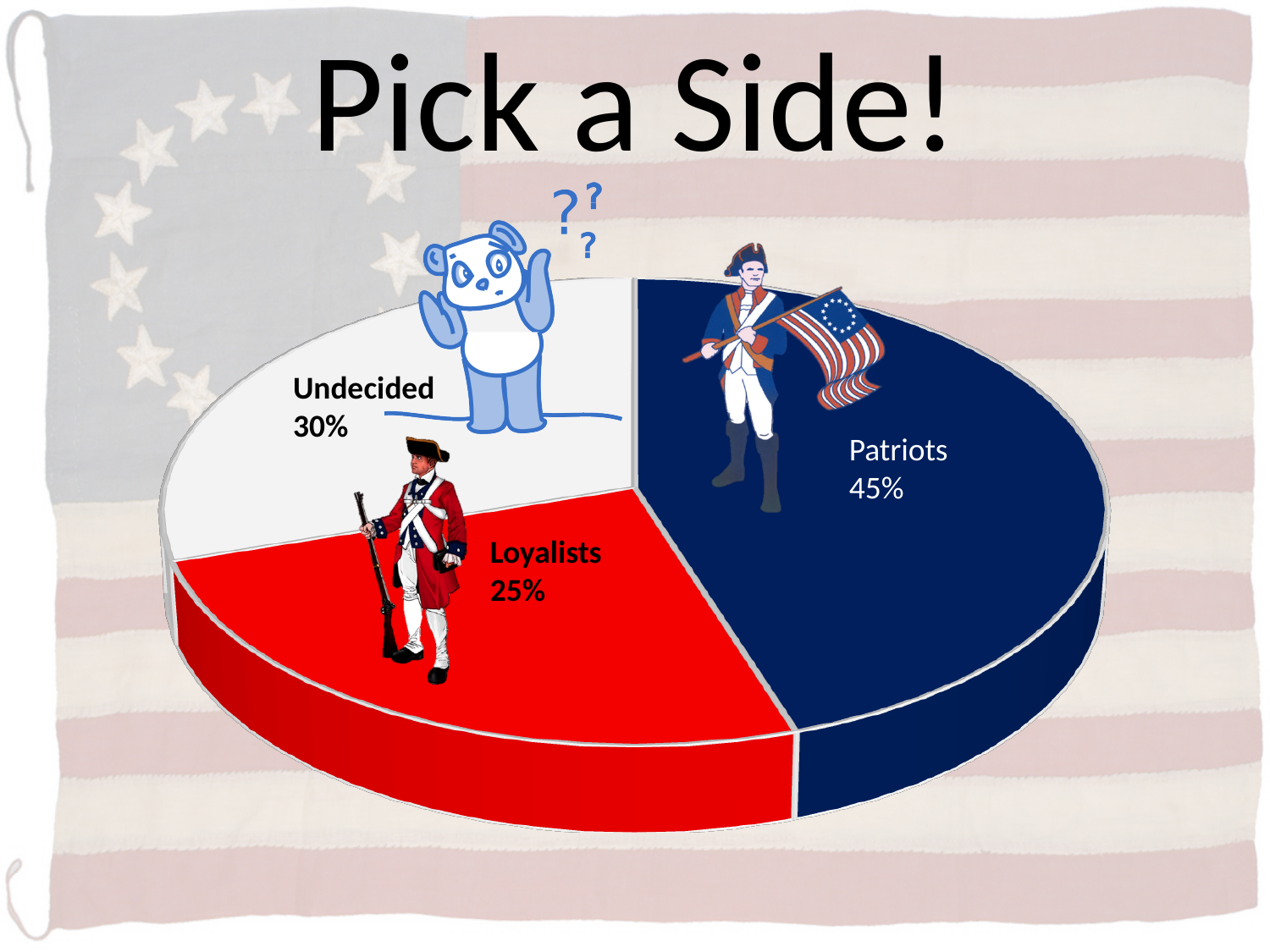
What colour is the Loyalists slice of the pie chart? Red Which slice of the pie chart is the smallest? Loyalists How many slices does the pie chart have? 3 What percentage of the pie chart is labelled Loyalists? 25% What is the title of the slide containing the pie chart? Pick a Side! What kind of chart is shown on the slide? Pie chart Which is larger, the Undecided slice or the Loyalists slice? Undecided What percentage of the pie chart is labelled Undecided? 30% What is the difference in percentage points between the Patriots and Loyalists slices? 20 Which slice of the pie chart is the largest? Patriots What percentage of the pie chart is labelled Patriots? 45% What is the difference in percentage points between the Undecided and Loyalists slices? 5